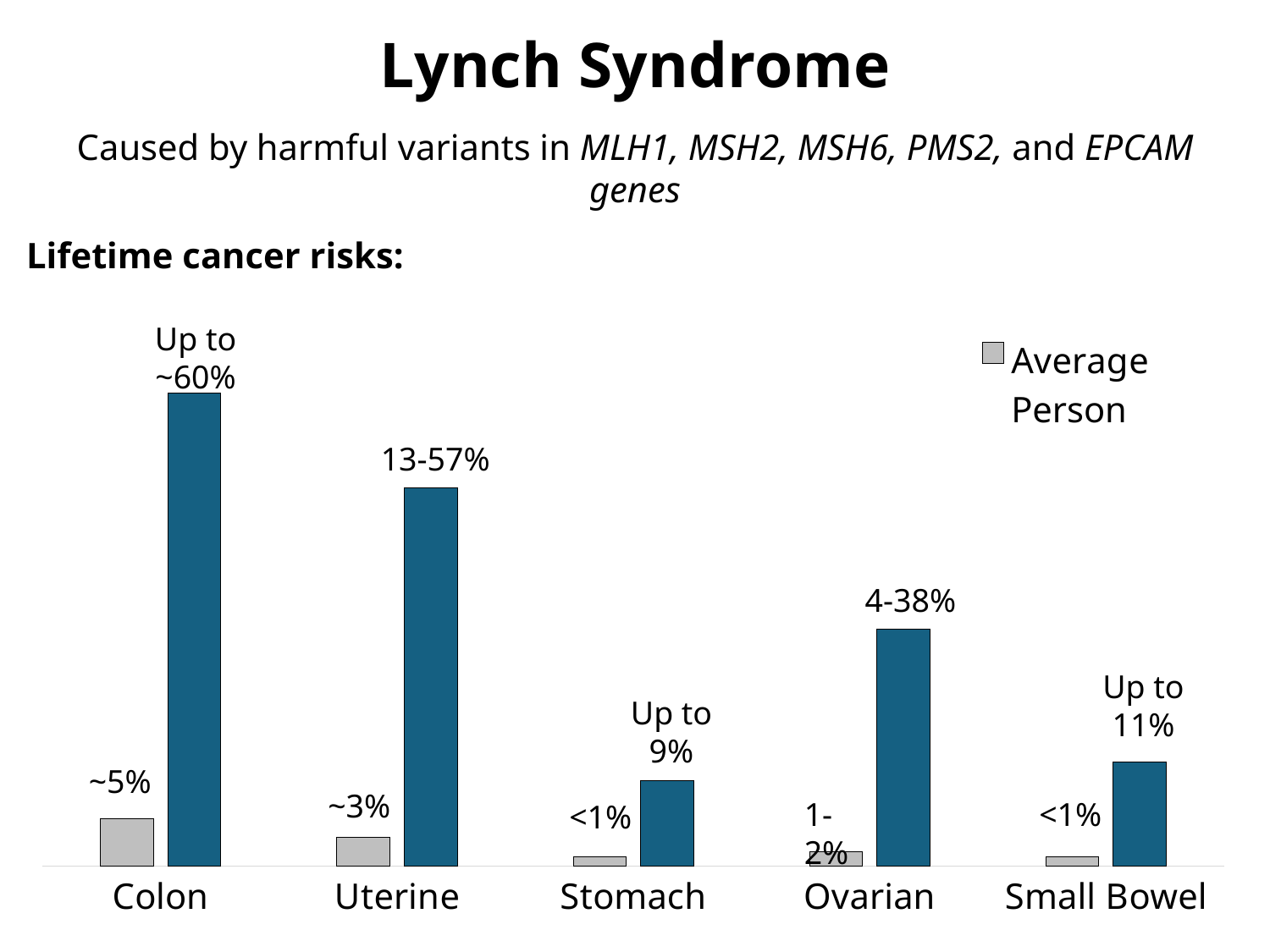
What is the data label on the taller (blue) bar for Small Bowel? Up to 11% What is the data label on the Average Person bar for Colon? ~5% How many cancer types are shown on the x axis? 5 What kind of chart is shown on the slide? bar chart What is the data label on the Average Person bar for Stomach? <1% What is the data label on the taller (blue) bar for Ovarian? 4-38% What series name is shown in the chart legend? Average Person What is the data label on the taller (blue) bar for Uterine? 13-57% Is the blue bar for Uterine taller or shorter than the blue bar for Ovarian? taller What is the data label on the Average Person bar for Uterine? ~3% Which cancer type has the tallest blue (Lynch syndrome) bar? Colon Which cancer type has the shortest blue (Lynch syndrome) bar? Stomach